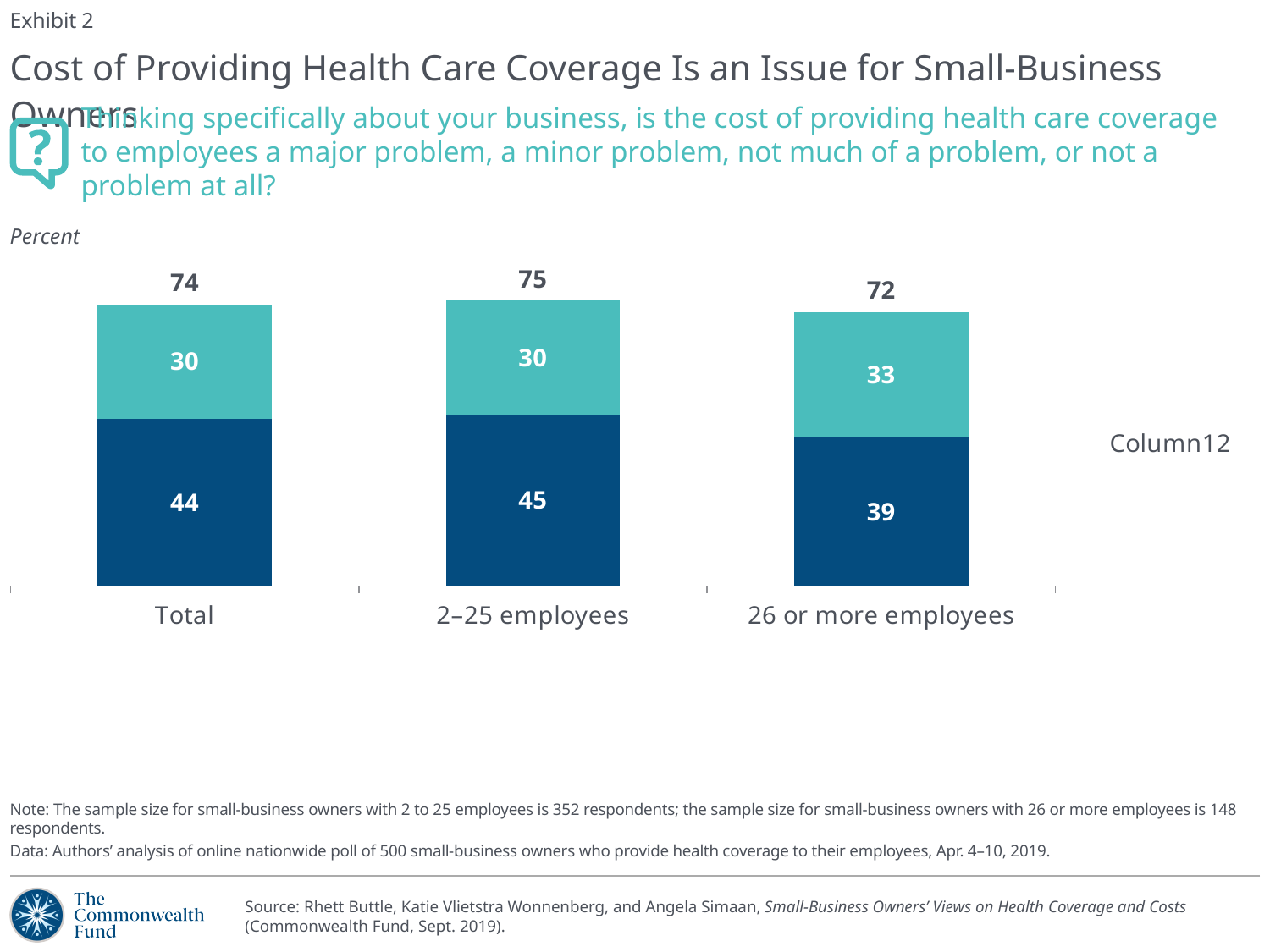
Which has the larger teal (upper) segment: 2–25 employees or 26 or more employees? 26 or more employees How many categories are shown on the x axis? 3 What is the value of the dark blue segment for 2–25 employees? 45 What is the total of the stacked bar for 26 or more employees? 72 Which category has the highest stacked bar total? 2–25 employees What is the difference between the stacked bar totals for 2–25 employees and 26 or more employees? 3 What is the value of the dark blue segment for Total? 44 What kind of chart is shown on the slide? Stacked bar chart What is the difference between the dark blue segment for Total and the dark blue segment for 26 or more employees? 5 What is the total of the stacked bar for 2–25 employees? 75 What is the value of the teal (upper) segment for 26 or more employees? 33 Which category has the lowest stacked bar total? 26 or more employees